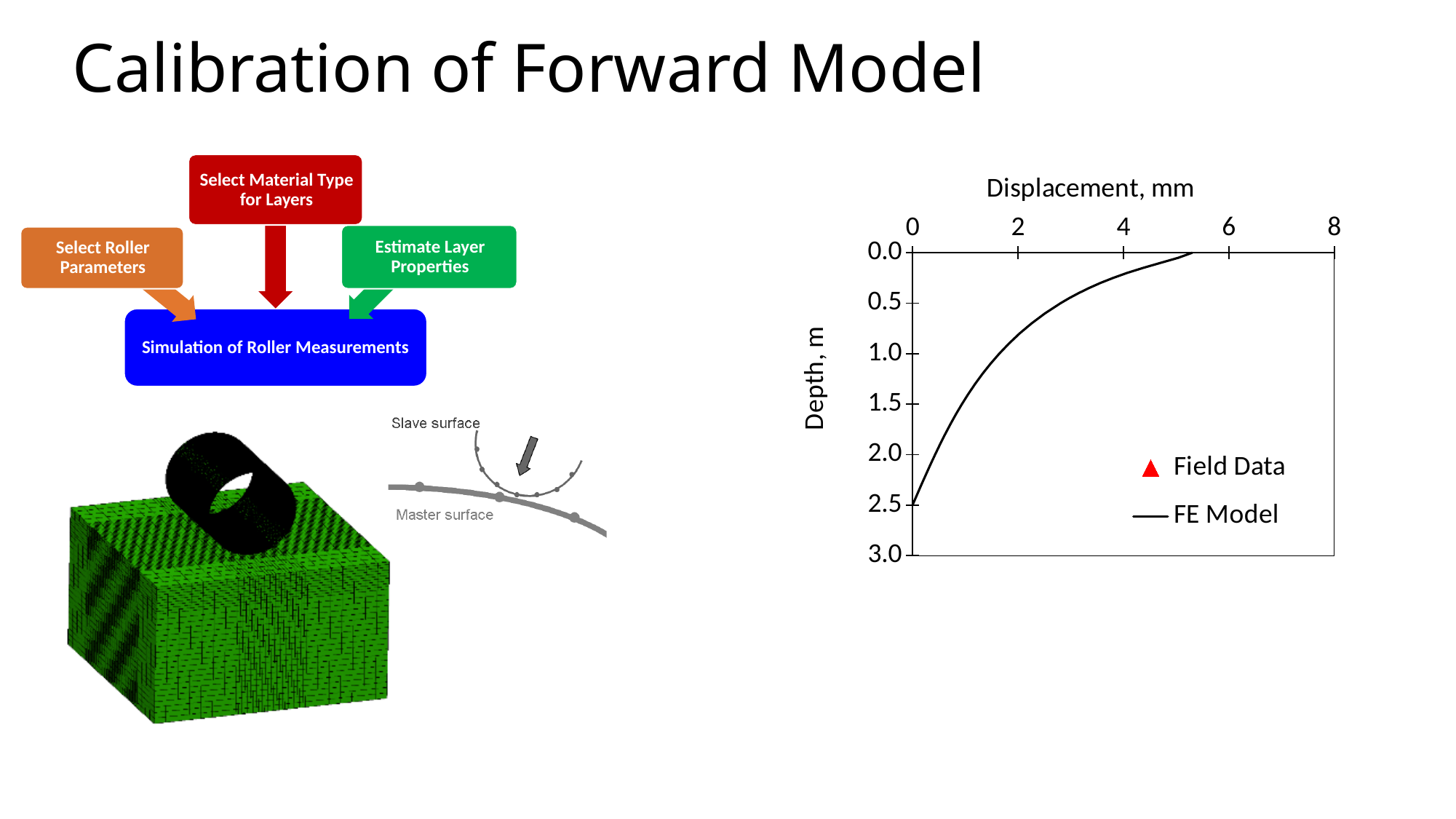
Is the displacement of the FE Model curve at a depth of 0.0 m greater or less than 4 mm? greater What kind of chart is shown on the right of the slide? line chart Which series in the chart is drawn as a solid black line? FE Model Is the displacement of the FE Model curve at a depth of 1.5 m greater or less than 2 mm? less What is the title of the horizontal axis of the chart? Displacement, mm What is the title of the vertical axis of the chart? Depth, m How many series does the chart legend list? 2 Does the displacement of the FE Model curve increase or decrease as depth increases? decrease Is the displacement of the FE Model curve at a depth of 0.5 m greater or less than 2 mm? greater